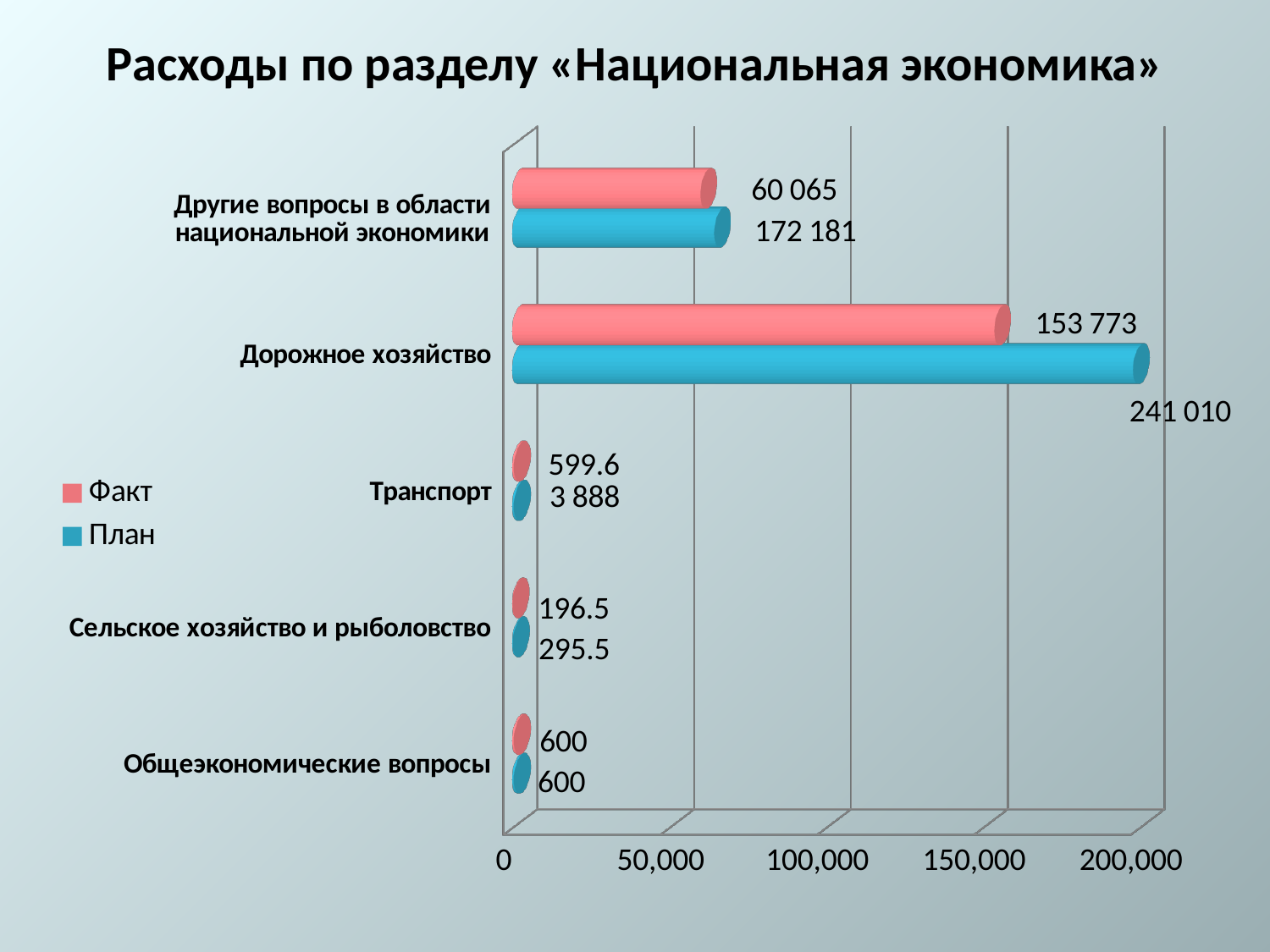
What is the План value for Другие вопросы в области национальной экономики? 172 181 What is the difference between the План and Факт values for Сельское хозяйство и рыболовство? 99 What is the План value for Транспорт? 3 888 What is the Факт value for Дорожное хозяйство? 153 773 How many series does the legend list? 2 Which is larger for Другие вопросы в области национальной экономики: the Факт value or the План value? План Which category has the highest План value? Дорожное хозяйство What is the difference between the План and Факт values for Дорожное хозяйство? 87 237 How many categories are shown on the chart? 5 Which category has the lowest Факт value? Сельское хозяйство и рыболовство What is the Факт value for Сельское хозяйство и рыболовство? 196.5 What type of chart is shown on the slide? Bar chart